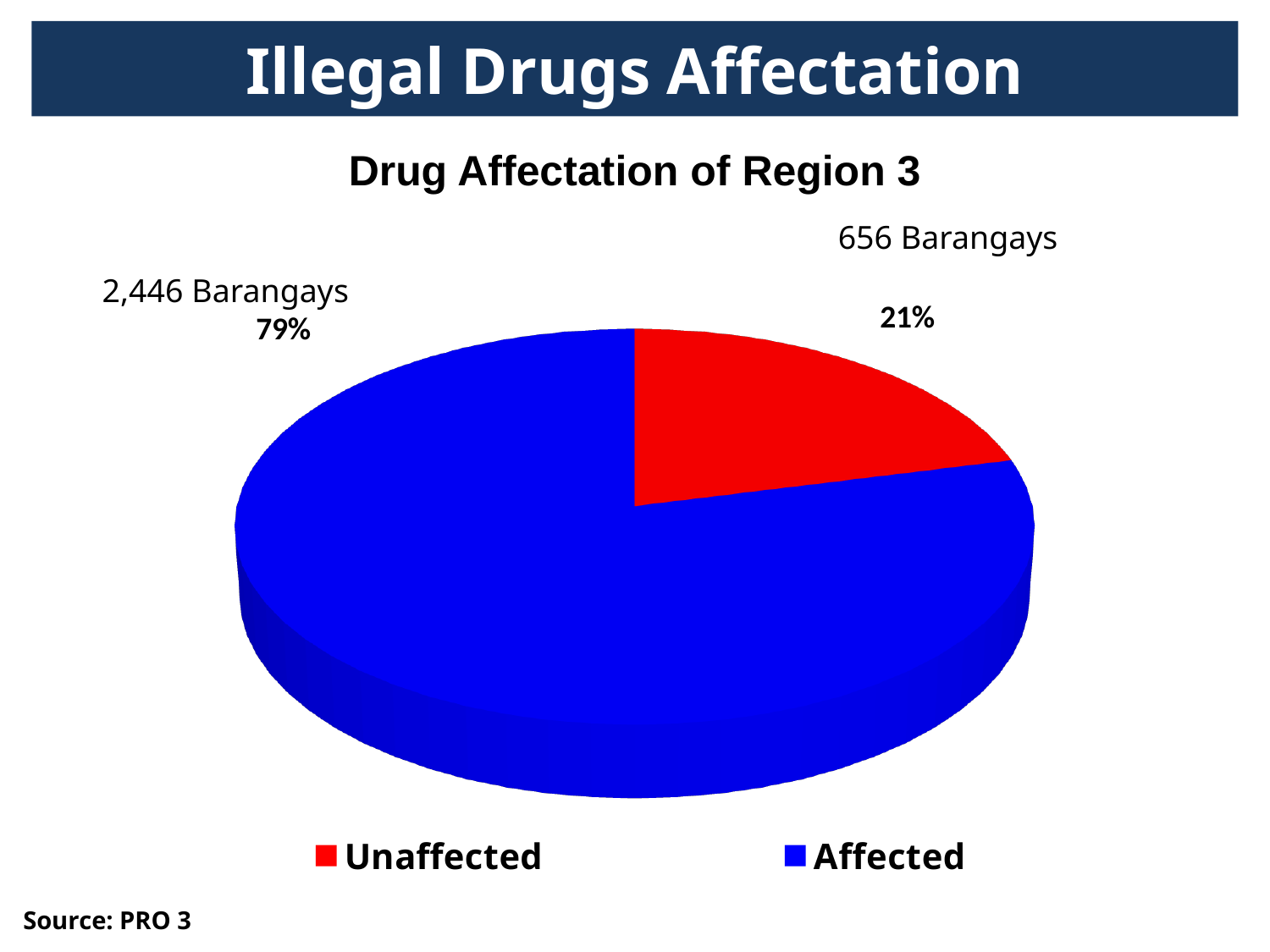
How many barangays are Affected according to the chart? 2,446 Barangays How many categories does the pie chart show? 2 What share of the pie is Unaffected? 21% What is the difference in barangays between Affected and Unaffected? 1,790 Barangays How many barangays are Unaffected according to the chart? 656 Barangays What is the total number of barangays shown in the chart? 3,102 Barangays What share of the pie is Affected? 79% Which category has the larger slice, Affected or Unaffected? Affected What is the title of the chart? Drug Affectation of Region 3 Which colour represents the Unaffected category in the legend? Red Which category has the smallest slice of the pie? Unaffected What kind of chart is shown on the slide? Pie chart